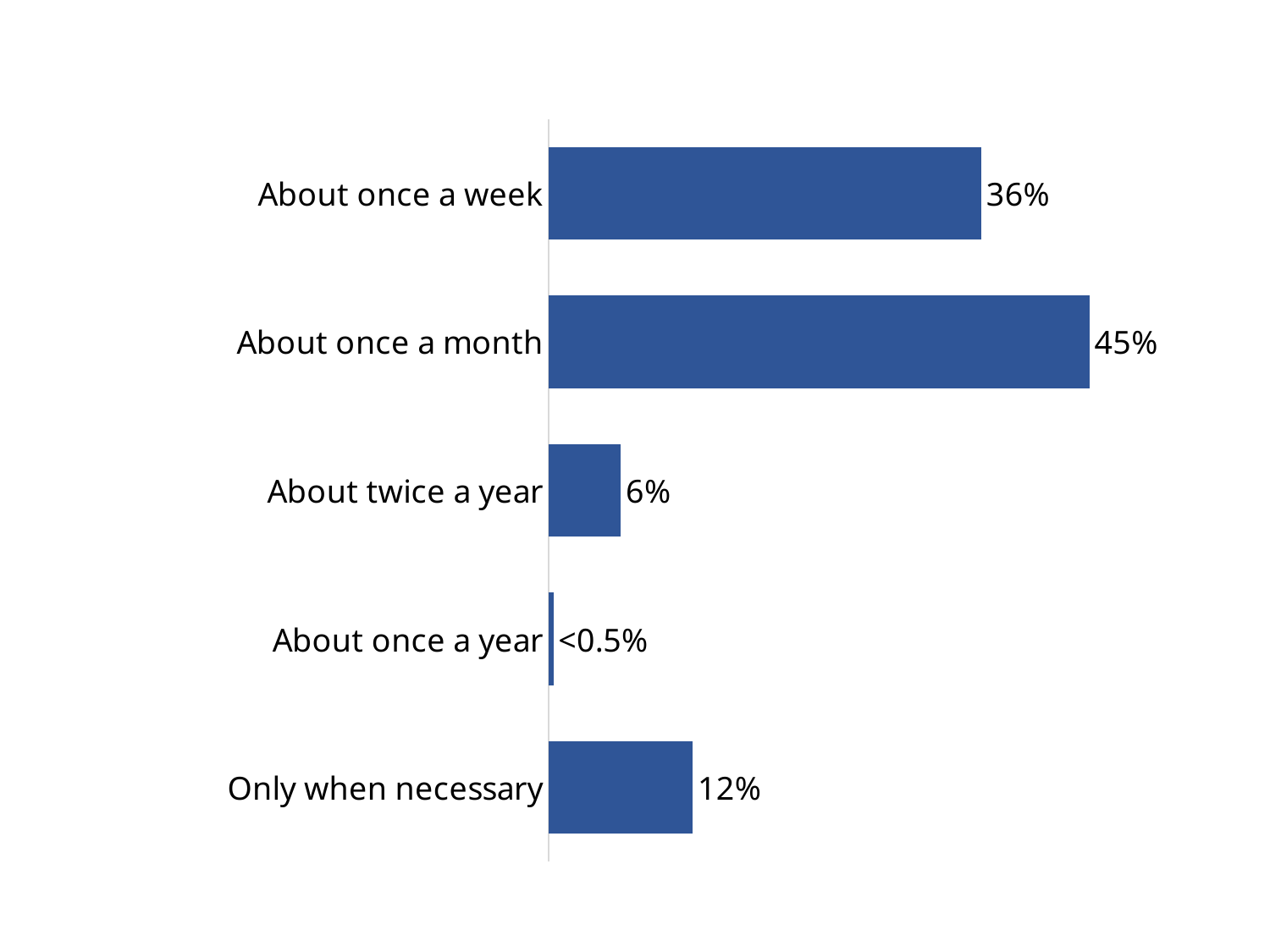
What is the value for "About once a week"? 36% Which category has the lowest value? About once a year What is the value shown for "About once a year"? <0.5% What is the difference between the values for "Only when necessary" and "About twice a year"? 6% Which category has the highest value? About once a month What kind of chart is shown on the slide? Bar chart What is the value for "About twice a year"? 6% Which is larger, the value for "About once a week" or the value for "Only when necessary"? About once a week How many categories are shown in the chart? 5 What is the difference between the values for "About once a month" and "About once a week"? 9% What is the value for "Only when necessary"? 12% What is the value for "About once a month"? 45%